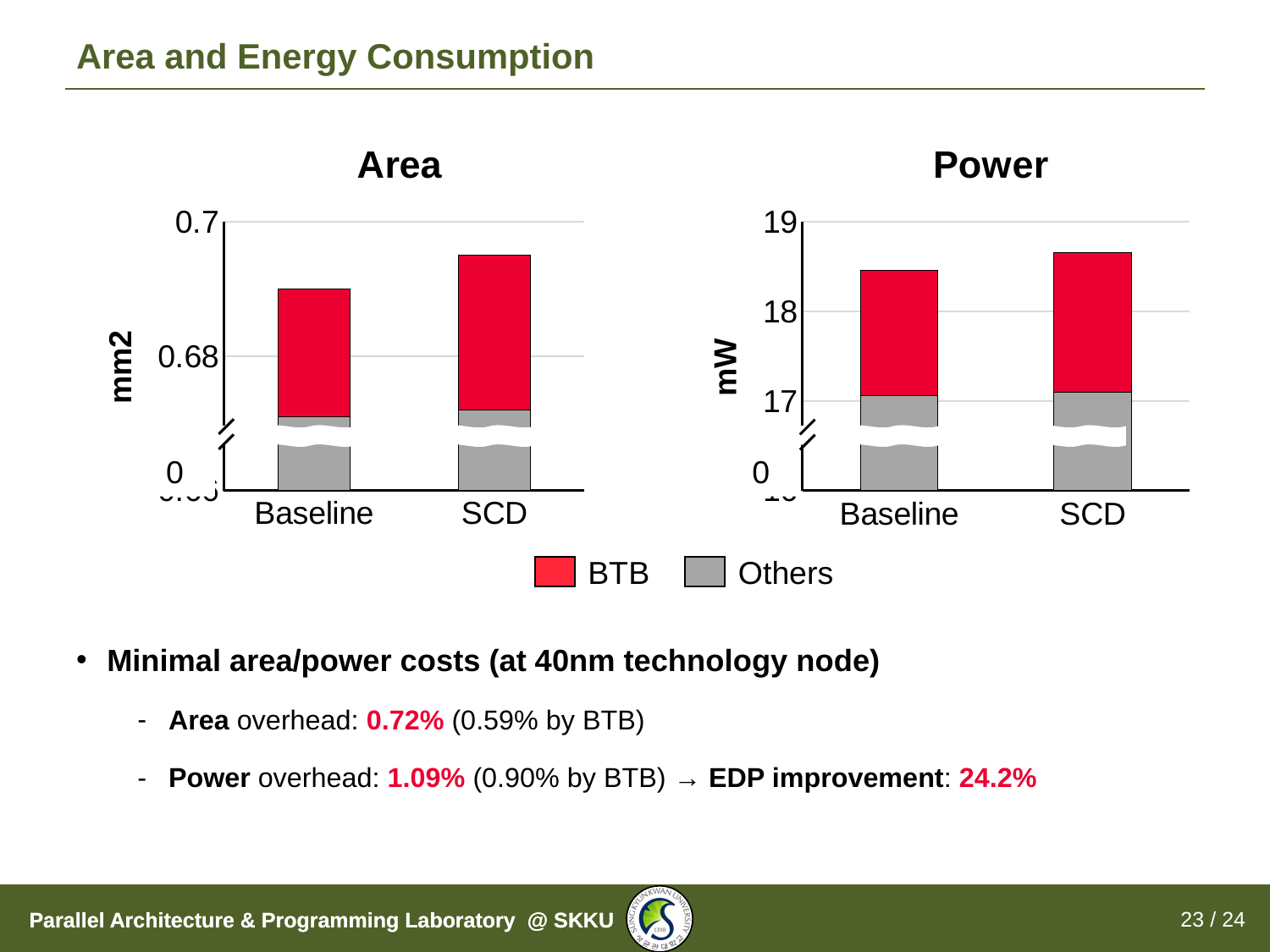
What kind of chart is the Area chart? Stacked bar chart How many categories are shown on the x axis of the Power chart? 2 In the Power chart, which category has the highest total bar? SCD Which series is shown in red in the legend? BTB In the Power chart, is the total value for SCD greater or less than 19? less In the Area chart, which category has the taller total bar, Baseline or SCD? SCD What unit is shown on the y axis of the Power chart? mW In the Power chart, is the total value for Baseline greater or less than 18? greater How many series does the legend list? 2 In the Area chart, is the total value for Baseline greater or less than 0.7? less In the Area chart, which category has the lowest total bar? Baseline